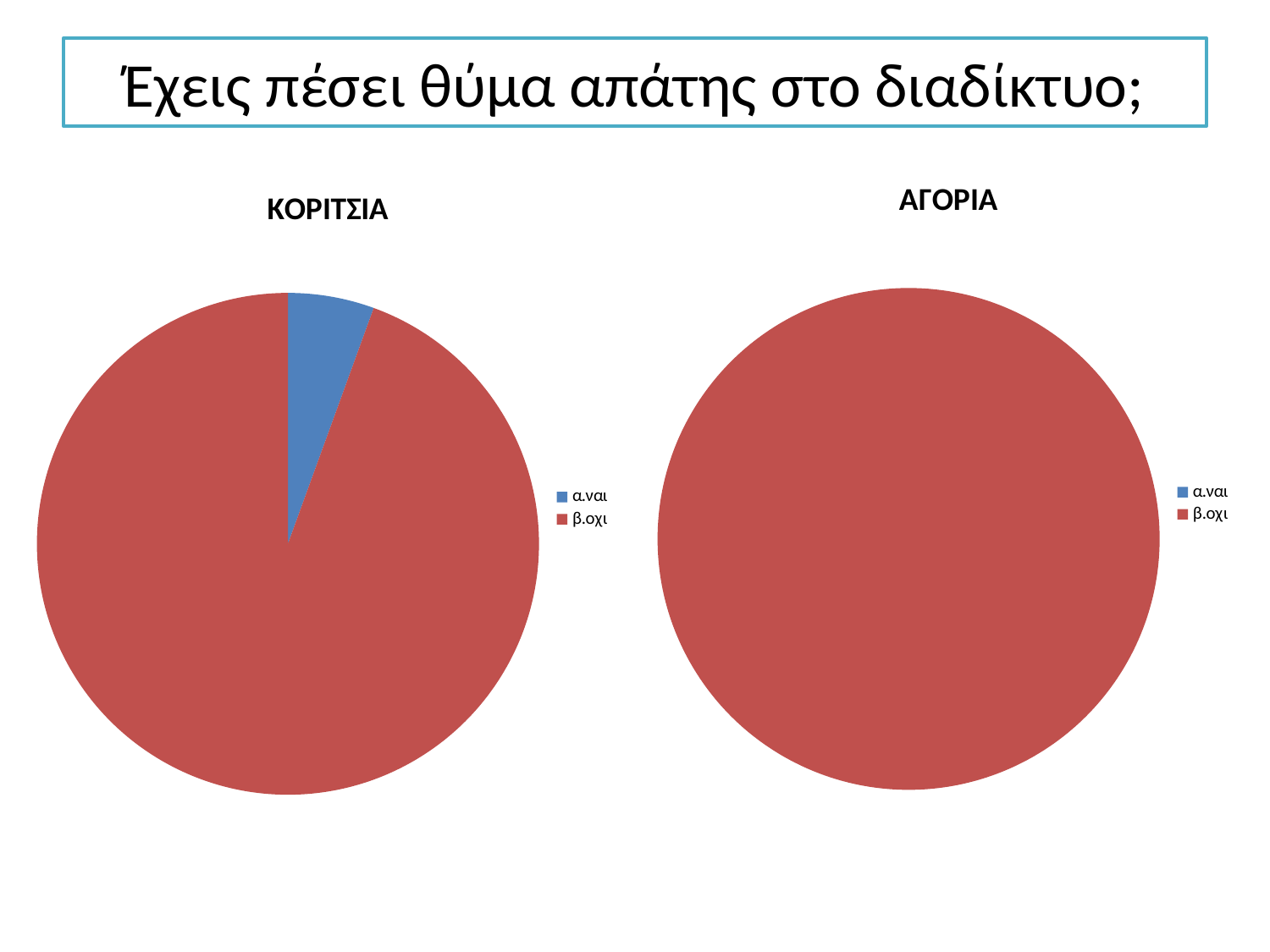
In the ΚΟΡΙΤΣΙΑ chart, which category has the smallest slice? α.ναι How many entries does the legend of the ΚΟΡΙΤΣΙΑ chart list? 2 In the ΑΓΟΡΙΑ chart, which is larger, α.ναι or β.οχι? β.οχι In the ΚΟΡΙΤΣΙΑ chart, which category has the largest slice? β.οχι What kind of chart is the ΑΓΟΡΙΑ chart? pie chart In the ΑΓΟΡΙΑ chart, which category has the largest slice? β.οχι What is the title of the left chart? ΚΟΡΙΤΣΙΑ What colour represents β.οχι in the ΑΓΟΡΙΑ chart? red What kind of chart is the ΚΟΡΙΤΣΙΑ chart? pie chart In the ΚΟΡΙΤΣΙΑ chart, which is larger, α.ναι or β.οχι? β.οχι How many entries does the legend of the ΑΓΟΡΙΑ chart list? 2